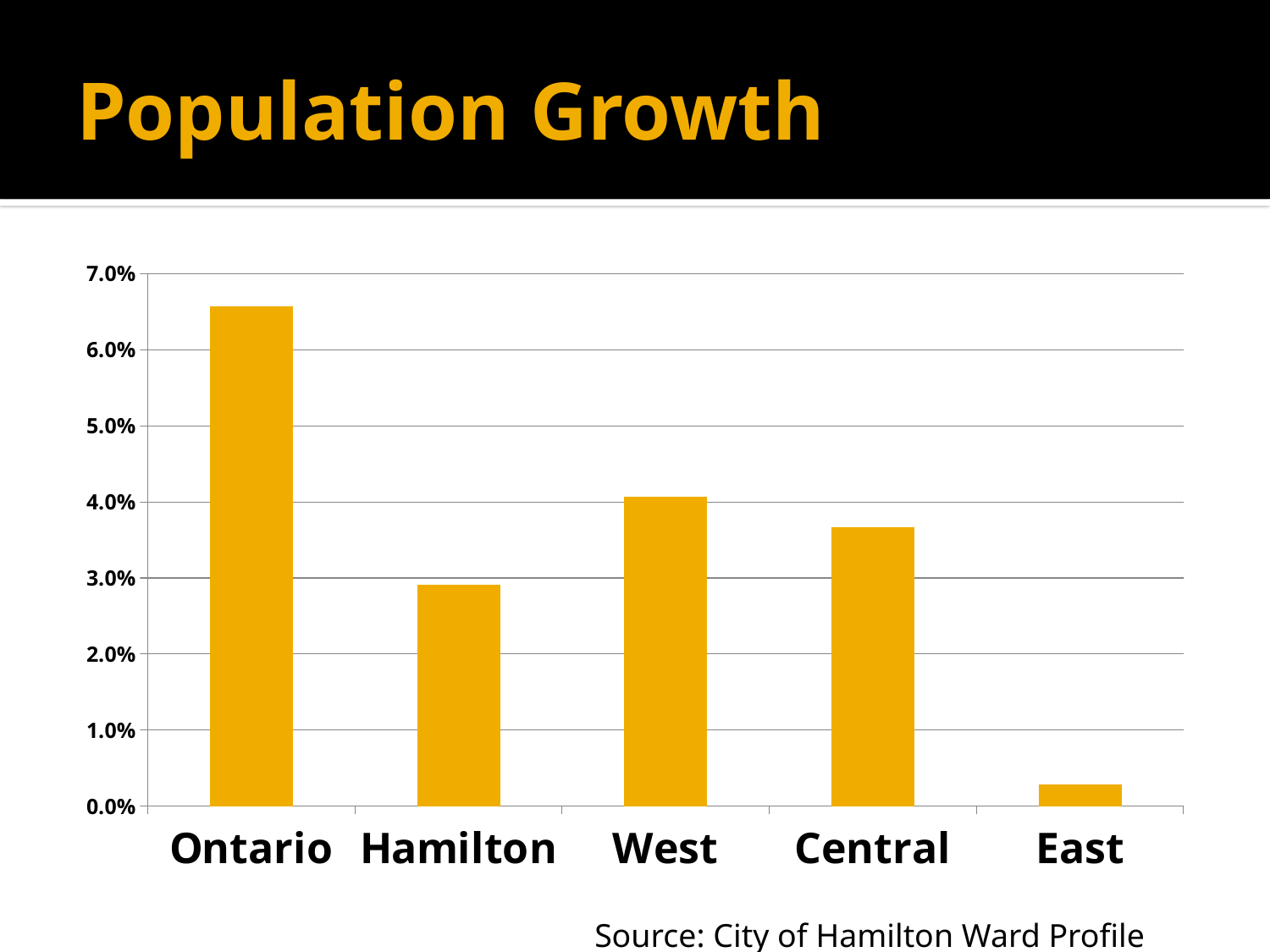
Which category has the highest population growth? Ontario Is the value for Central greater or less than 4.0%? less Which is larger, the value for Hamilton or the value for East? Hamilton Is the value for West greater or less than 5.0%? less Is the value for Ontario greater or less than 6.0%? greater Which is larger, the value for West or the value for Central? West Which category has the lowest population growth? East How many categories are shown on the x axis? 5 What is the title of the slide's chart? Population Growth What kind of chart is shown on the slide? bar chart